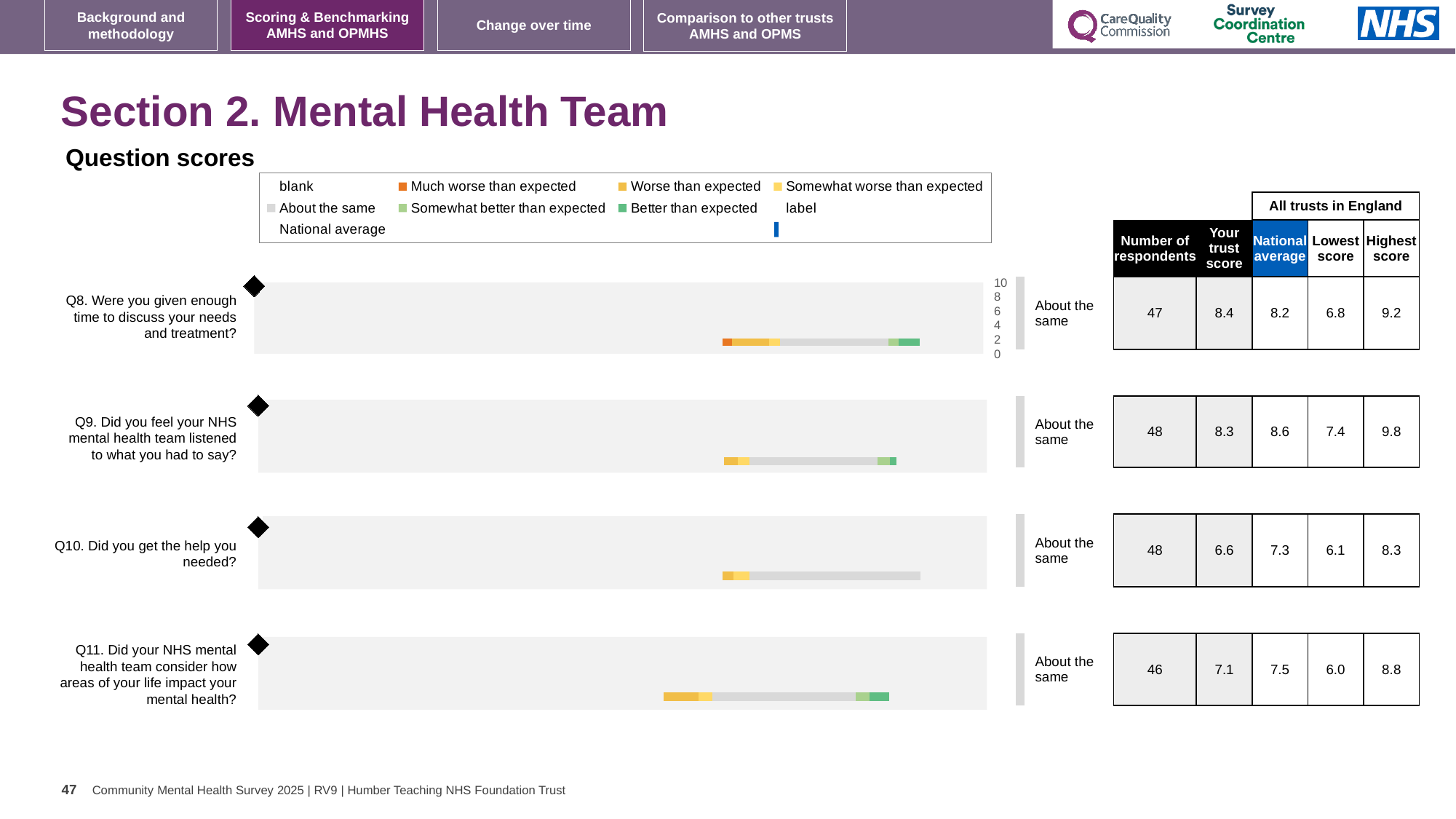
For Q10, which is larger: the trust score or the national average? National average Which question has the lowest number of respondents? Q11 What is the highest value shown on the vertical axis next to the Q8 chart? 10 Which question has the highest 'Your trust score'? Q8 What is the difference between the highest score and the lowest score for Q10? 2.2 What kind of chart is used to show the expected range for Q8? Bar chart What is the highest score among all trusts in England for Q9? 9.8 Which colour in the legend represents 'Much worse than expected'? Orange What is the national average for Q10 (Did you get the help you needed)? 7.3 How many respondents answered Q11? 46 What is the 'Your trust score' for Q8 (Were you given enough time to discuss your needs and treatment)? 8.4 How many question charts are shown on the slide? 4